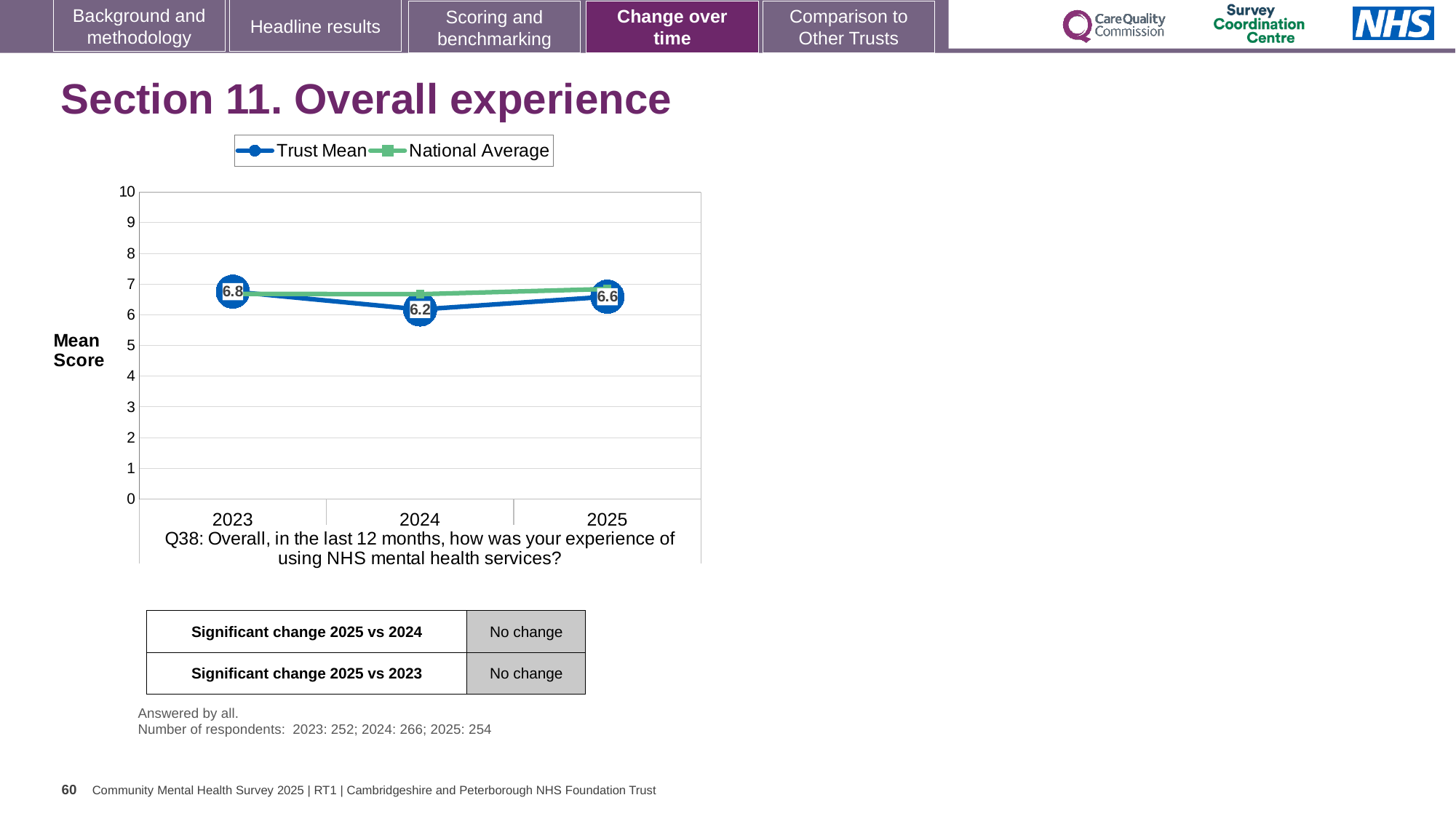
In 2024, which is higher, the Trust Mean or the National Average? National Average Is the National Average value for 2025 greater or less than 5? greater In which year is the Trust Mean score lowest? 2024 Which year has the larger Trust Mean score, 2023 or 2025? 2023 What is the Trust Mean score for 2024? 6.2 How many series does the legend list? 2 What is the difference between the Trust Mean scores for 2023 and 2024? 0.6 What is the Trust Mean score for 2025? 6.6 What is the Trust Mean score for 2023? 6.8 In which year is the Trust Mean score highest? 2023 What kind of chart is shown on the slide? line chart How many years are plotted on the x axis? 3